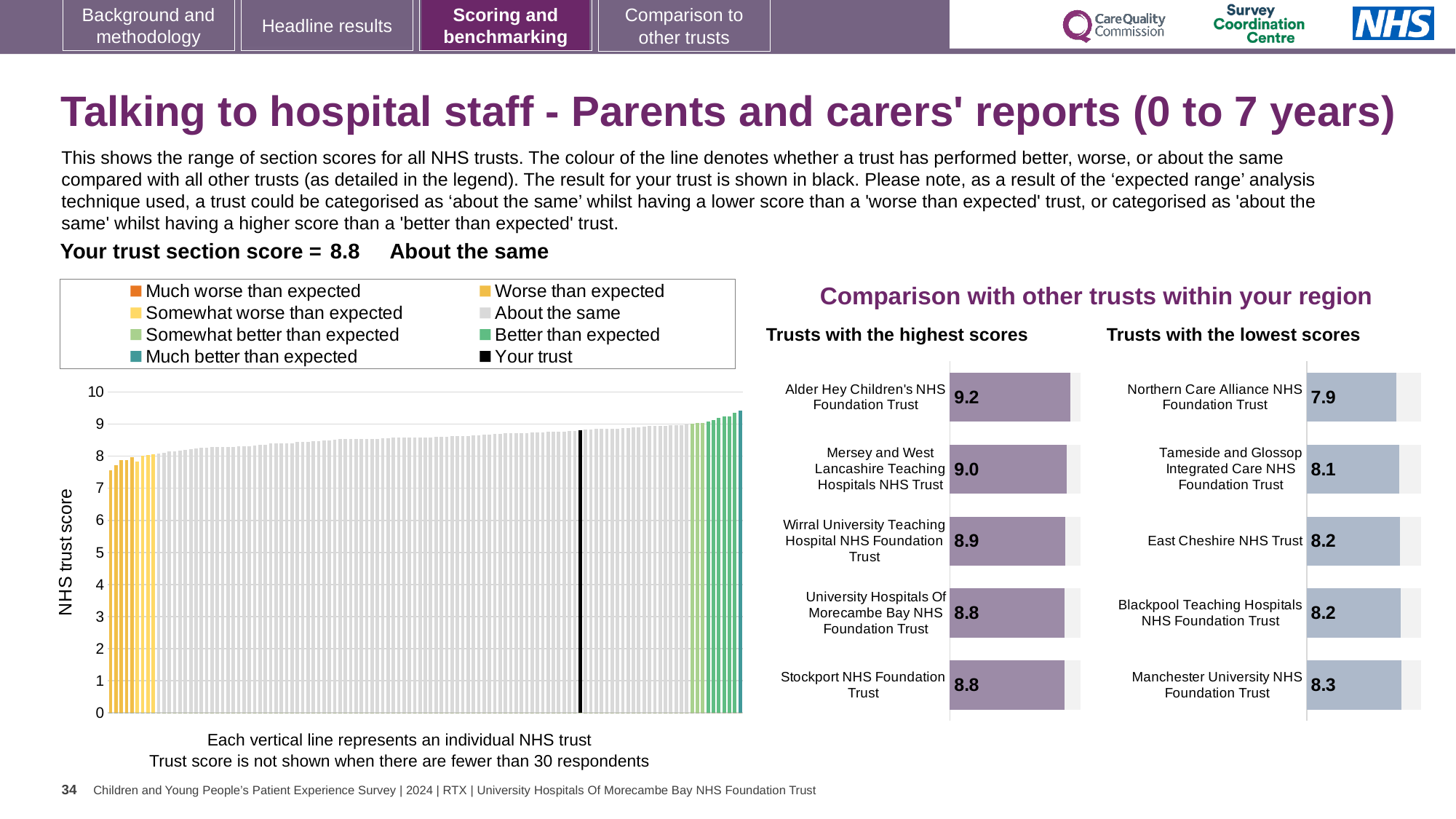
In the 'Trusts with the highest scores' chart, which trust has the highest score? Alder Hey Children's NHS Foundation Trust In the 'Trusts with the lowest scores' chart, which has the higher score: Tameside and Glossop Integrated Care NHS Foundation Trust or Manchester University NHS Foundation Trust? Manchester University NHS Foundation Trust In the 'Trusts with the lowest scores' chart, what is the score for Manchester University NHS Foundation Trust? 8.3 In the 'Trusts with the lowest scores' chart, what is the score for Northern Care Alliance NHS Foundation Trust? 7.9 In the 'Trusts with the highest scores' chart, what is the score for Wirral University Teaching Hospital NHS Foundation Trust? 8.9 In the main NHS trust score chart, do the values rise or fall from left to right? Rise How many entries does the legend of the main NHS trust score chart list? 8 In the 'Trusts with the highest scores' chart, what is the score for Alder Hey Children's NHS Foundation Trust? 9.2 What kind of chart is the main chart on the left showing NHS trust scores? Bar chart How many trusts are shown in the 'Trusts with the highest scores' chart? 5 In the 'Trusts with the highest scores' chart, what is the difference between the scores of Alder Hey Children's NHS Foundation Trust and Stockport NHS Foundation Trust? 0.4 In the 'Trusts with the lowest scores' chart, which trust has the lowest score? Northern Care Alliance NHS Foundation Trust